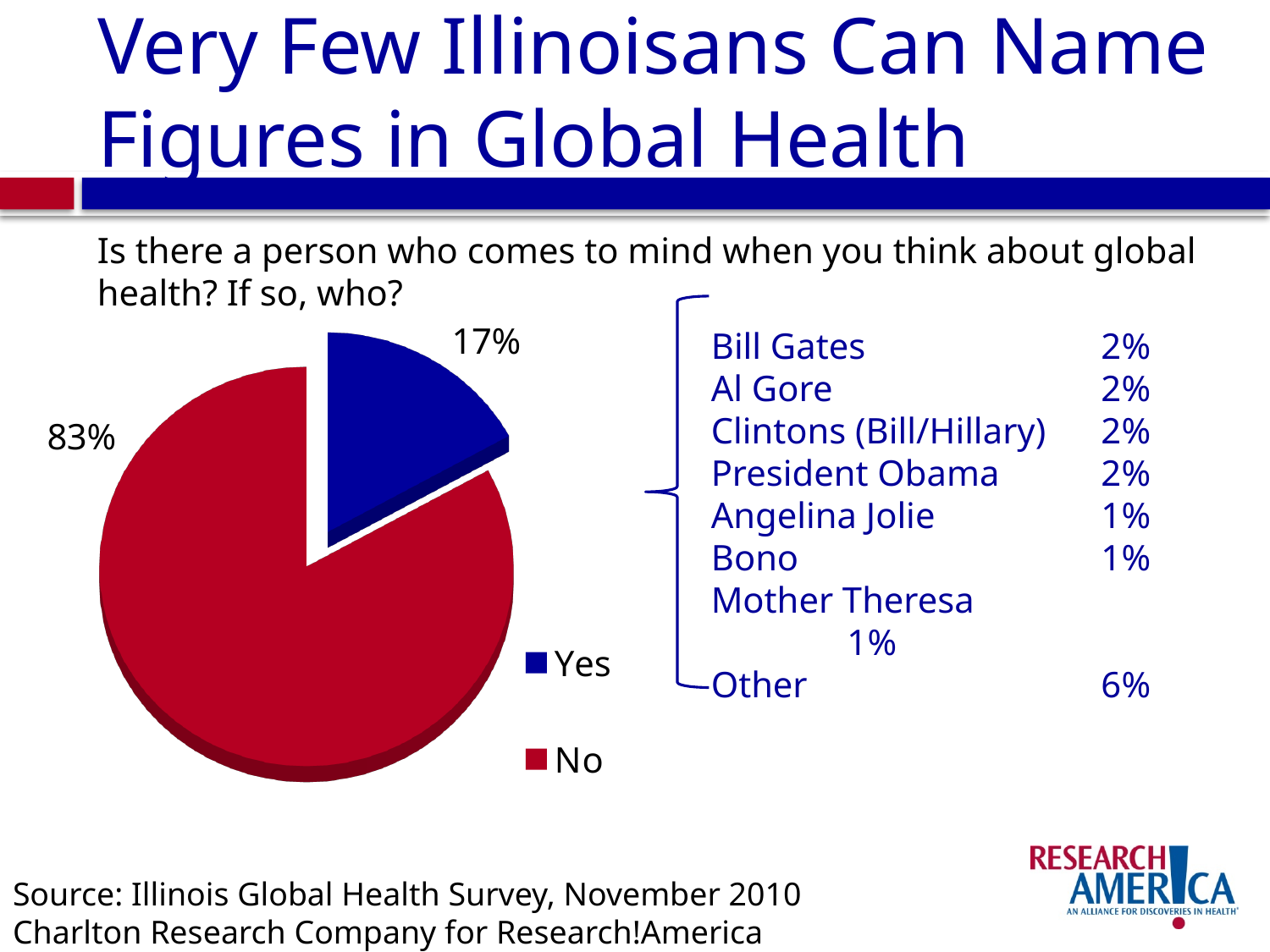
How many slices does the pie chart have? 2 What percentage of respondents answered Yes? 17% What is the difference in percentage points between the No and Yes slices? 66 How many entries does the legend list? 2 Which slice of the pie is the largest? No What colour is the No slice? red What colour is the Yes slice? blue What kind of chart is shown on the slide? pie chart Which is larger, the Yes slice or the No slice? No What percentage of respondents answered No? 83% Which slice of the pie is the smallest? Yes What share of the pie does the Yes slice represent? 17%